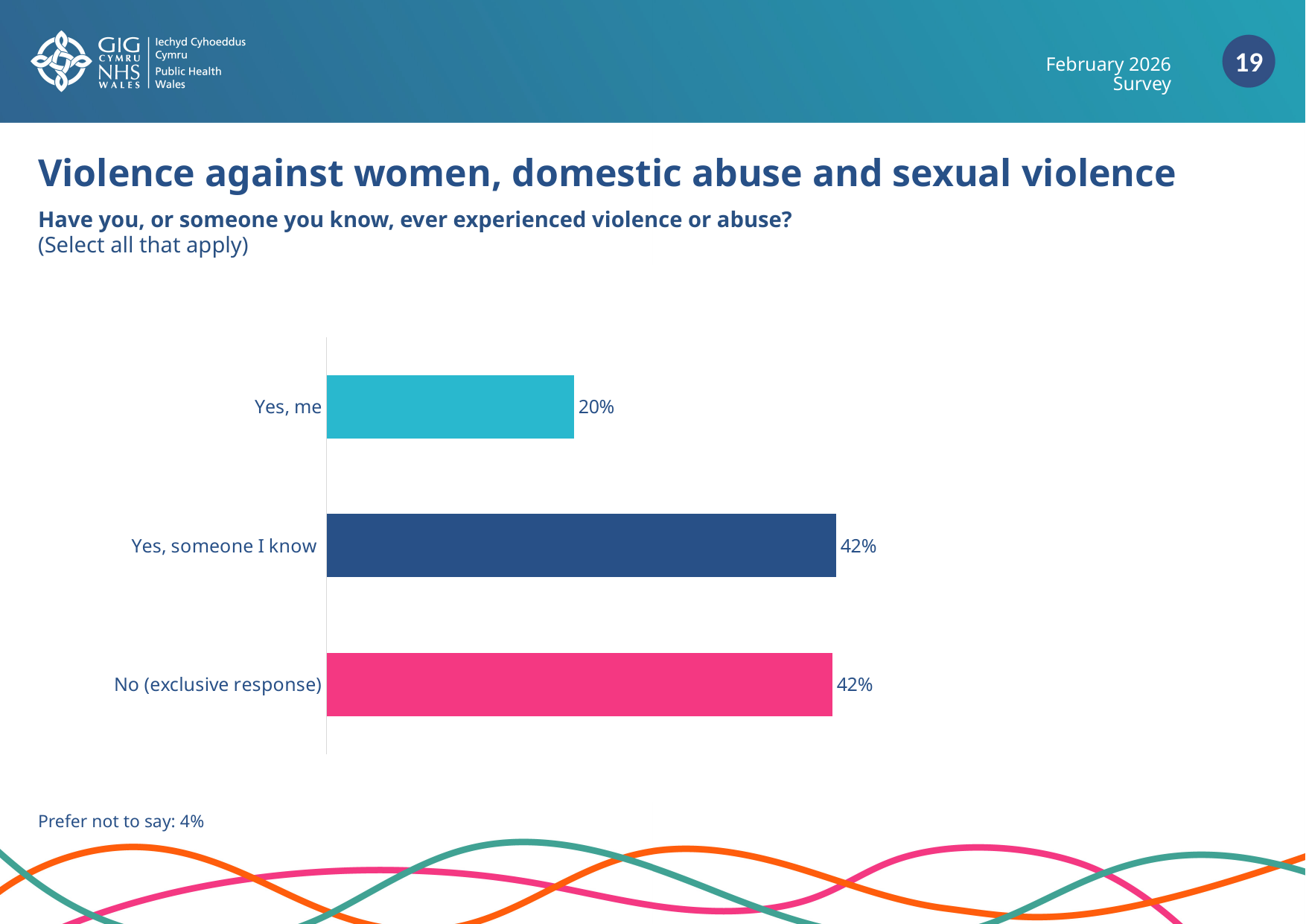
Which response category has the lowest value? Yes, me What colour is the bar for "No (exclusive response)"? Pink What percentage of respondents selected "Yes, someone I know"? 42% What percentage of respondents preferred not to say, according to the note below the chart? 4% What percentage of respondents selected "Yes, me"? 20% What survey question does the chart present? Have you, or someone you know, ever experienced violence or abuse? How many response categories are plotted in the chart? 3 What percentage of respondents selected "No (exclusive response)"? 42% What is the difference between the values for "Yes, someone I know" and "Yes, me"? 22 percentage points Which is larger: the value for "Yes, me" or the value for "No (exclusive response)"? No (exclusive response) What kind of chart is shown on the slide? Bar chart